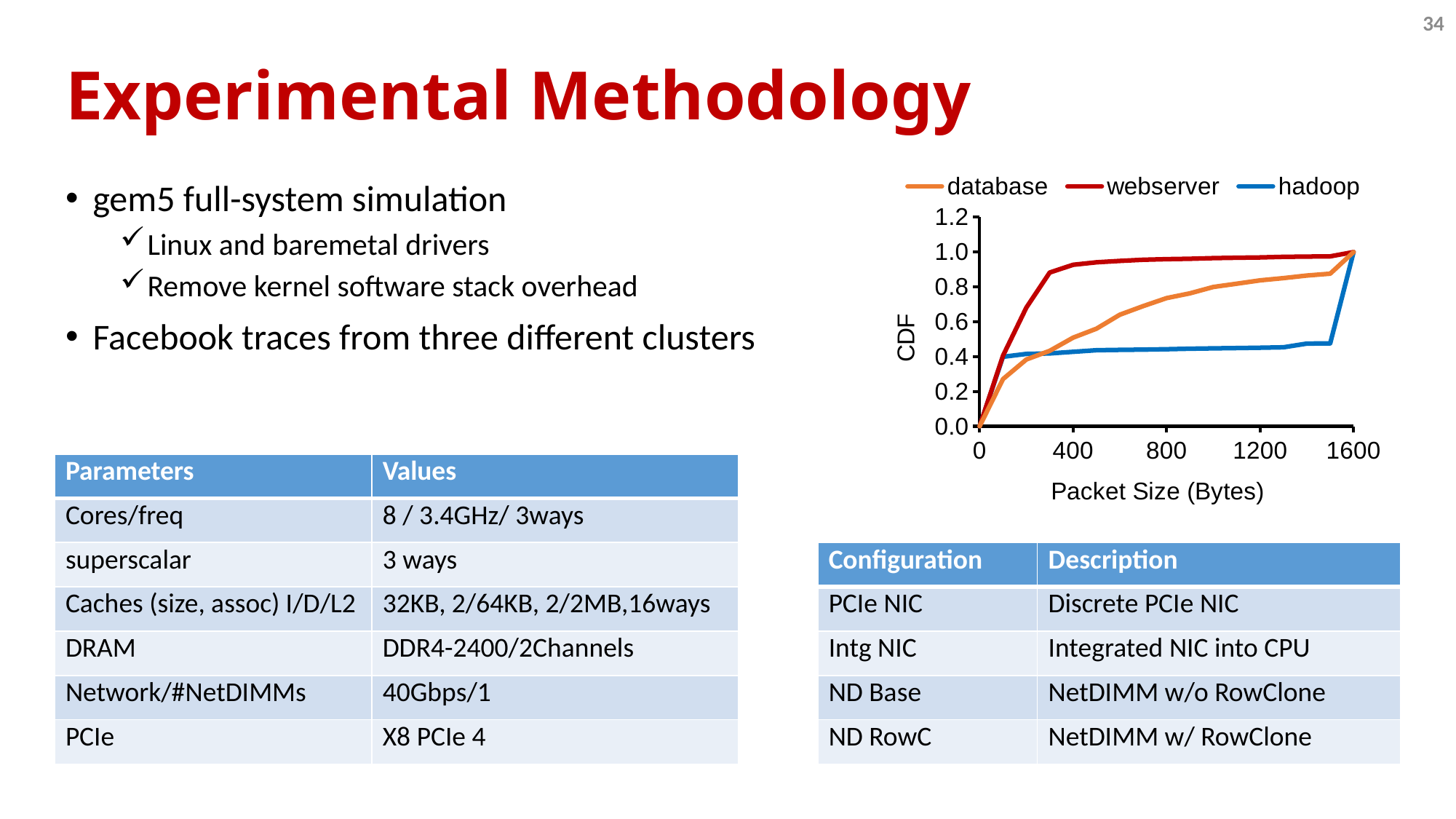
Is the CDF value for webserver at a packet size of 400 bytes greater or less than 0.8? greater What is the label of the chart's x axis? Packet Size (Bytes) At a packet size of 800 bytes, which series has the higher CDF value, webserver or hadoop? webserver What kind of chart is shown on the slide? line chart What are the series names listed in the chart's legend? database, webserver, hadoop How many series does the chart's legend list? 3 Is the CDF value for database at a packet size of 800 bytes greater or less than 0.6? greater Do the CDF values for the database series rise or fall as packet size increases along the x axis? rise Is the CDF value for hadoop at a packet size of 800 bytes greater or less than 0.6? less Which series has the lowest CDF value at a packet size of 800 bytes? hadoop At a packet size of 1200 bytes, which series has the higher CDF value, database or hadoop? database